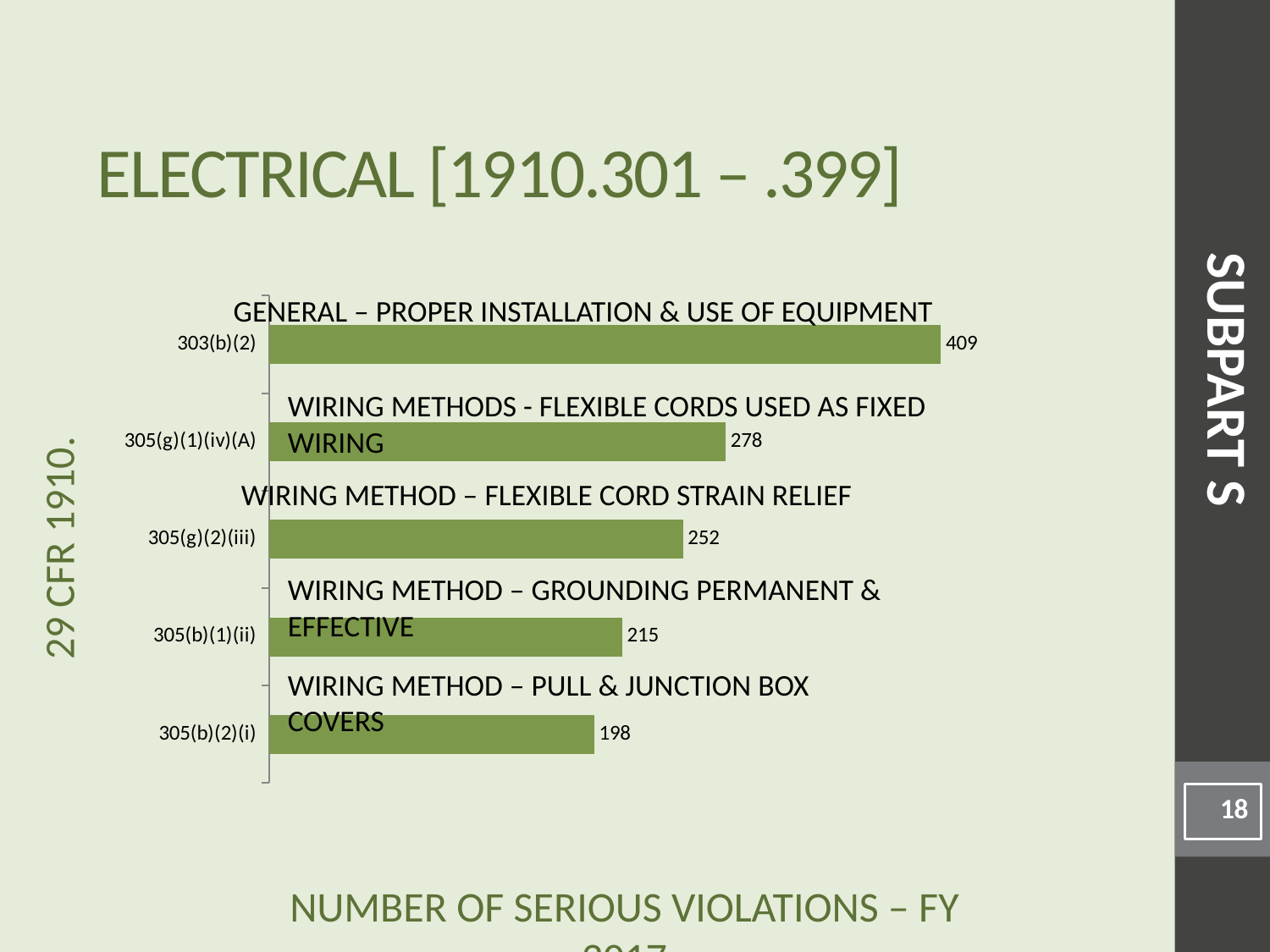
What is the value shown for 305(b)(1)(ii)? 215 What is the value shown for 305(g)(2)(iii)? 252 What kind of chart is shown on the slide? Bar chart What is the difference between the values for 303(b)(2) and 305(g)(1)(iv)(A)? 131 How many categories are shown in the chart? 5 Which category has the highest number of serious violations? 303(b)(2) What is the value shown for 305(g)(1)(iv)(A)? 278 What is the number of serious violations for 303(b)(2)? 409 Which is larger, the value for 305(g)(2)(iii) or the value for 305(b)(1)(ii)? 305(g)(2)(iii) What is the value shown for 305(b)(2)(i)? 198 Which category has the lowest number of serious violations? 305(b)(2)(i)